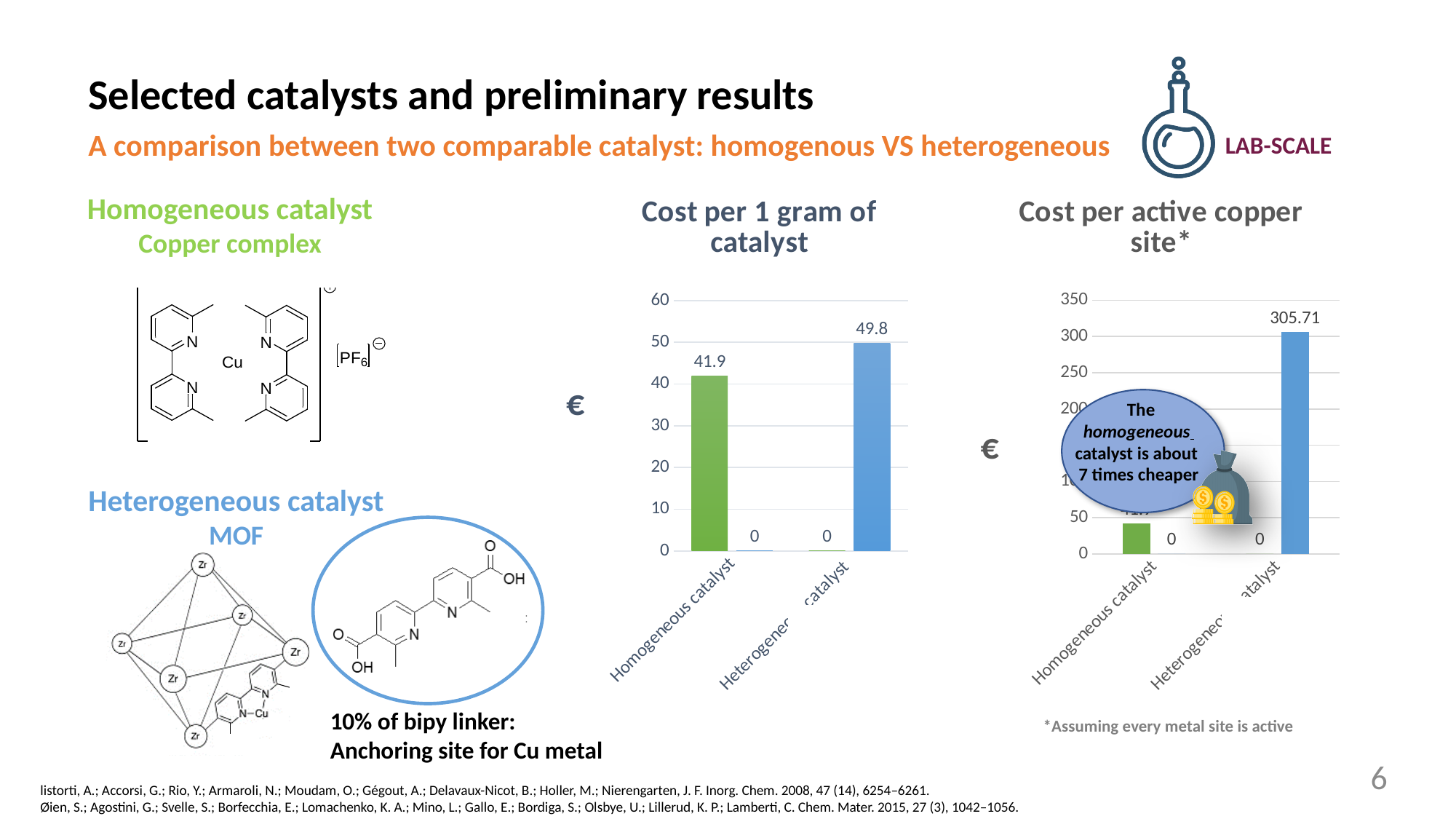
In the 'Cost per active copper site*' chart, which catalyst has the higher cost? Heterogeneous catalyst In the 'Cost per active copper site*' chart, is the value for the Heterogeneous catalyst greater or less than 300? greater What is the maximum value shown on the vertical axis of the 'Cost per active copper site*' chart? 350 In the 'Cost per 1 gram of catalyst' chart, what is the difference between the Heterogeneous and Homogeneous catalyst values? 7.9 In the 'Cost per active copper site*' chart, what is the value for the Heterogeneous catalyst? 305.71 What unit symbol is shown next to the vertical axis of the 'Cost per 1 gram of catalyst' chart? € In the 'Cost per 1 gram of catalyst' chart, is the value for the Homogeneous catalyst greater or less than 50? less In the 'Cost per 1 gram of catalyst' chart, what is the value for the Heterogeneous catalyst? 49.8 In the 'Cost per 1 gram of catalyst' chart, what is the value for the Homogeneous catalyst? 41.9 In the 'Cost per 1 gram of catalyst' chart, which catalyst has the higher cost? Heterogeneous catalyst What type of chart is the 'Cost per 1 gram of catalyst' chart? Bar chart In the 'Cost per active copper site*' chart, is the value for the Homogeneous catalyst greater or less than 100? less